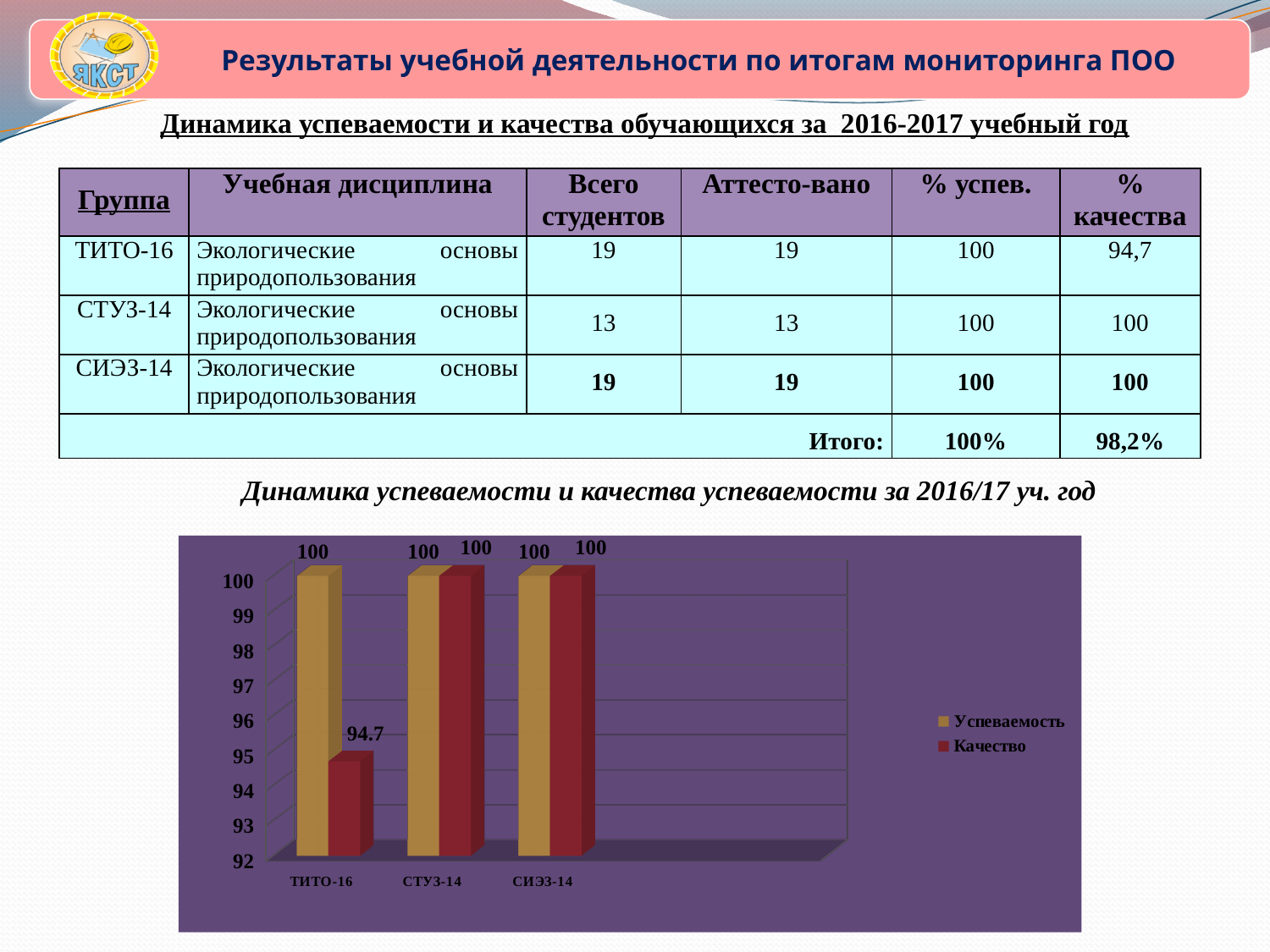
What is the value of Успеваемость for СИЭЗ-14? 100 Is the Качество value for ТИТО-16 greater or less than 96? less What is the difference between Успеваемость and Качество for ТИТО-16? 5.3 What is the value of Качество for ТИТО-16? 94.7 How many series does the chart legend list? 2 What is the value of Успеваемость for ТИТО-16? 100 Which series is shown in red in the chart? Качество What type of chart is shown on the slide? bar chart What is the value of Качество for СТУЗ-14? 100 Which is larger for ТИТО-16, Успеваемость or Качество? Успеваемость How many groups are shown on the x axis of the chart? 3 Which group has the lowest Качество value? ТИТО-16